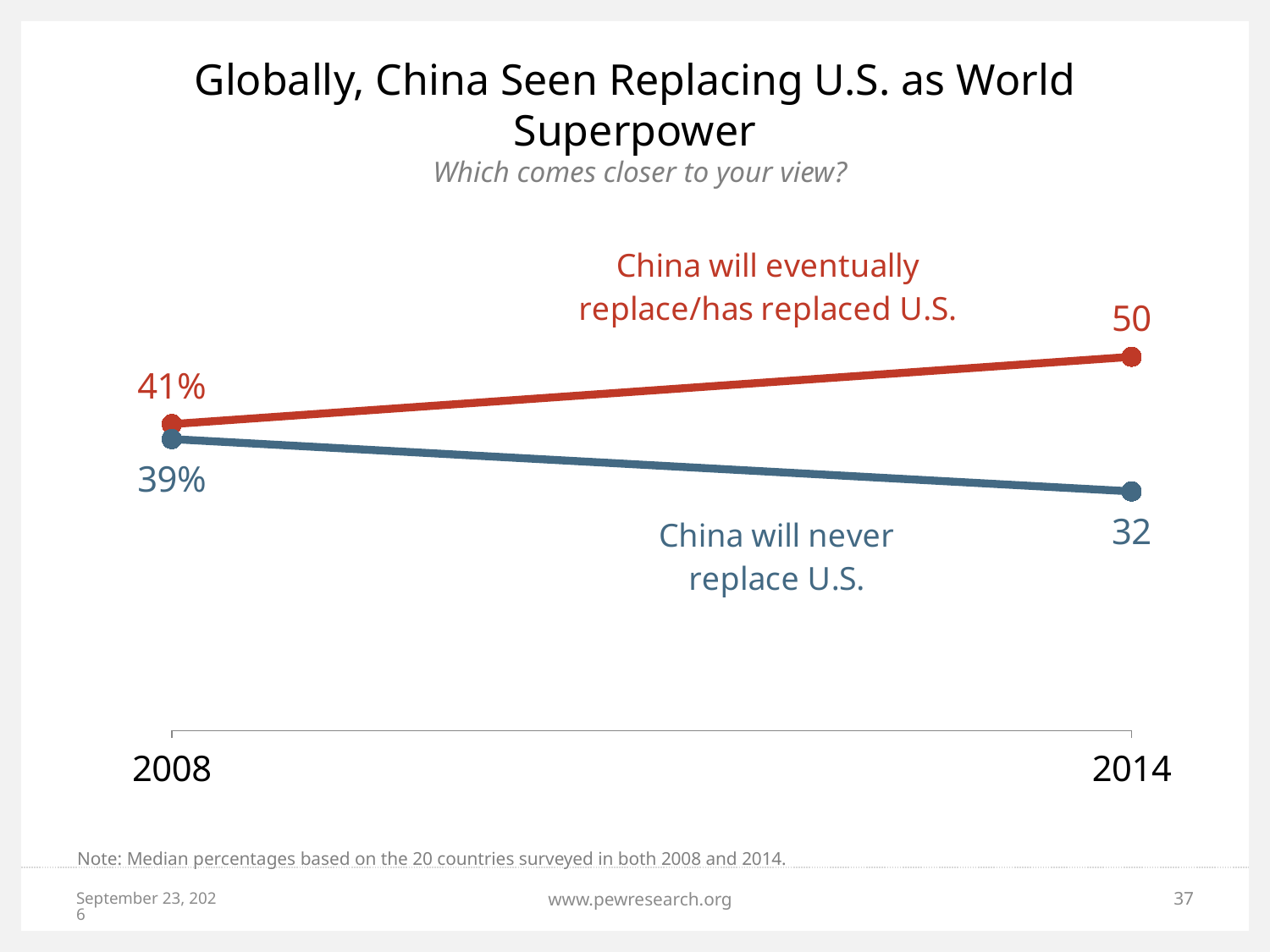
How many years are shown on the x axis? 2 What is the value for "China will eventually replace/has replaced U.S." in 2008? 41% What is the value for "China will never replace U.S." in 2008? 39% What is the value for "China will eventually replace/has replaced U.S." in 2014? 50 What is the value for "China will never replace U.S." in 2014? 32 By how much did the "China will eventually replace/has replaced U.S." value change from 2008 to 2014? 9 What is the difference between the two series' values in 2014? 18 Does the "China will never replace U.S." line rise or fall from 2008 to 2014? fall How many series are plotted on the chart? 2 Which series has the higher value in 2014? China will eventually replace/has replaced U.S. What kind of chart is shown on the slide? line chart Does the "China will eventually replace/has replaced U.S." line rise or fall from 2008 to 2014? rise